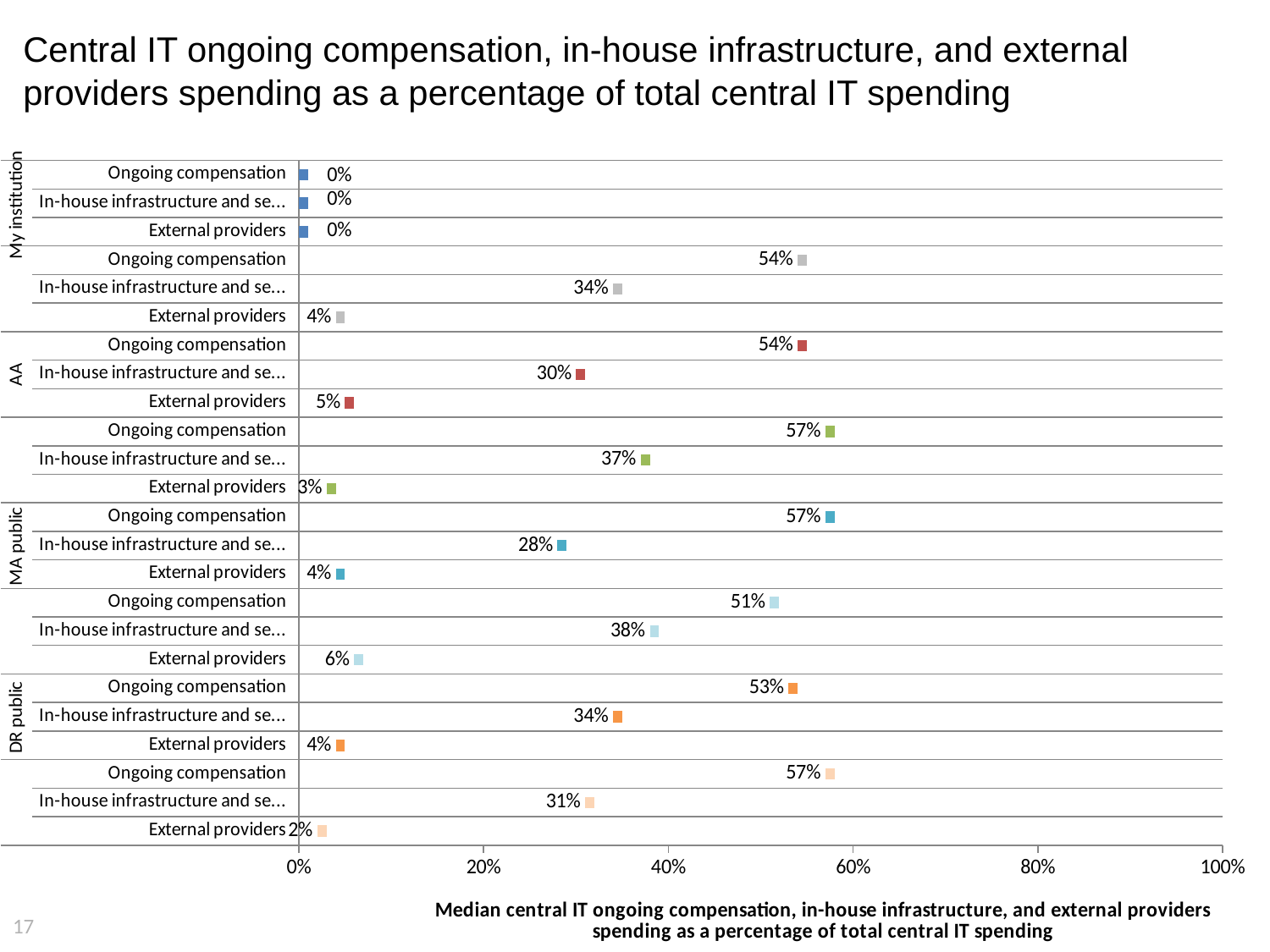
What is the difference between Ongoing compensation and In-house infrastructure and services in the AA group? 24% How many data rows are plotted on the chart? 24 What is the value for Ongoing compensation in the AA group? 54% What is the x-axis title of the chart? Median central IT ongoing compensation, in-house infrastructure, and external providers spending as a percentage of total central IT spending What is the value for Ongoing compensation in the DR public group? 53% What is the value for External providers in the DR public group? 4% What is the value for External providers in the My institution group? 0% Which is larger: In-house infrastructure and services for AA or for DR public? DR public What is the difference between Ongoing compensation and In-house infrastructure and services in the DR public group? 19% Is the value for Ongoing compensation in the MA public group greater or less than 40%? greater What is the value for In-house infrastructure and services in the MA public group? 28% Which is larger in the MA public group: Ongoing compensation or In-house infrastructure and services? Ongoing compensation